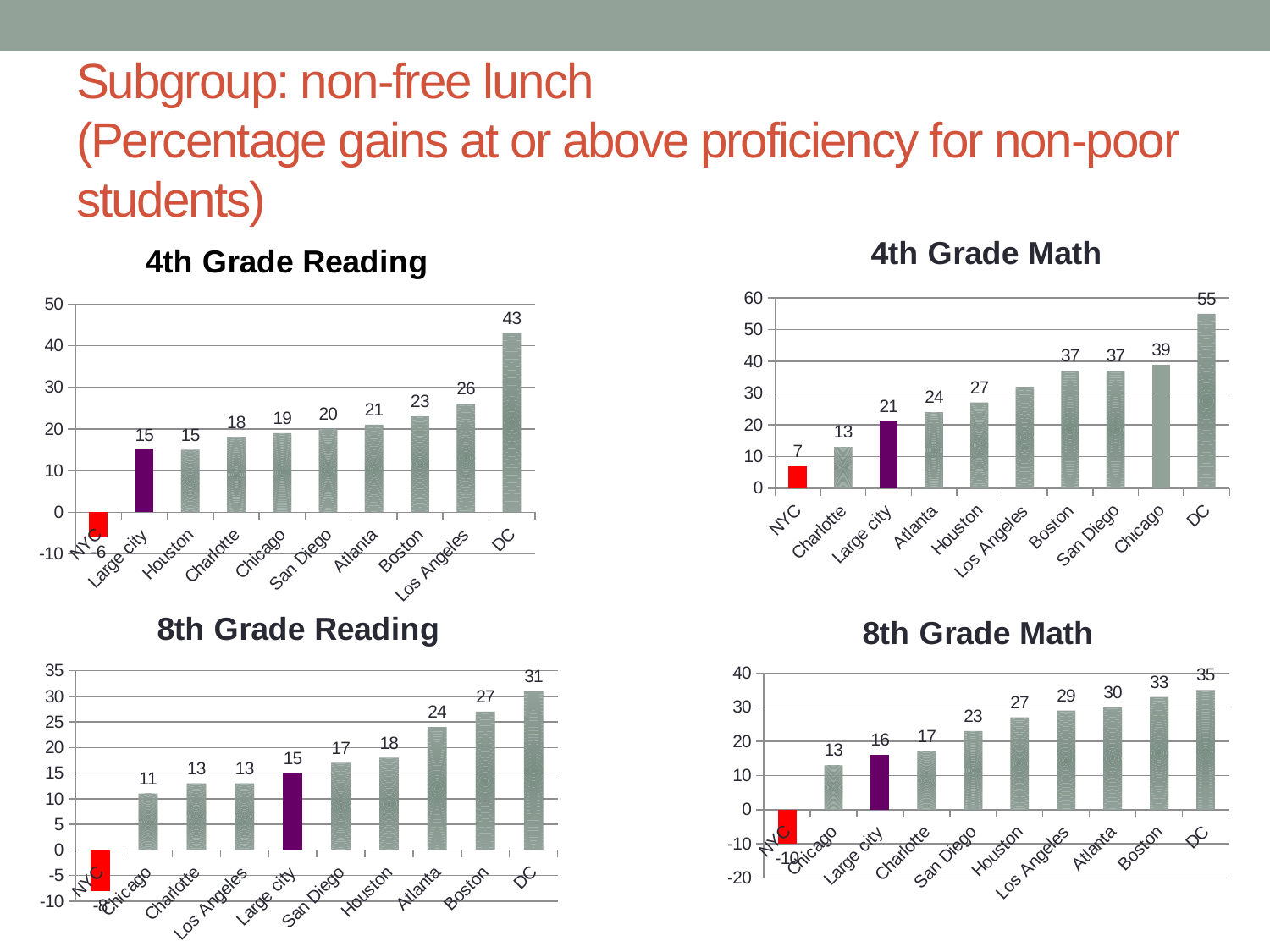
In the 8th Grade Reading chart, which city has the lowest value? NYC In the 8th Grade Math chart, what is the value for NYC? -10 What type of chart is the 4th Grade Reading chart? Bar chart In the 4th Grade Math chart, which city has the highest value? DC In the 8th Grade Math chart, which is larger, the value for Houston or the value for San Diego? Houston In the 4th Grade Math chart, what is the value for Large city? 21 How many cities are shown in the 8th Grade Math chart? 10 In the 8th Grade Reading chart, do the values generally rise or fall from left to right? Rise In the 4th Grade Reading chart, what is the value for DC? 43 In the 4th Grade Reading chart, what is the value for NYC? -6 In the 8th Grade Reading chart, what is the difference between the values for DC and Boston? 4 In the 4th Grade Math chart, is the value for Los Angeles greater or less than 30? greater